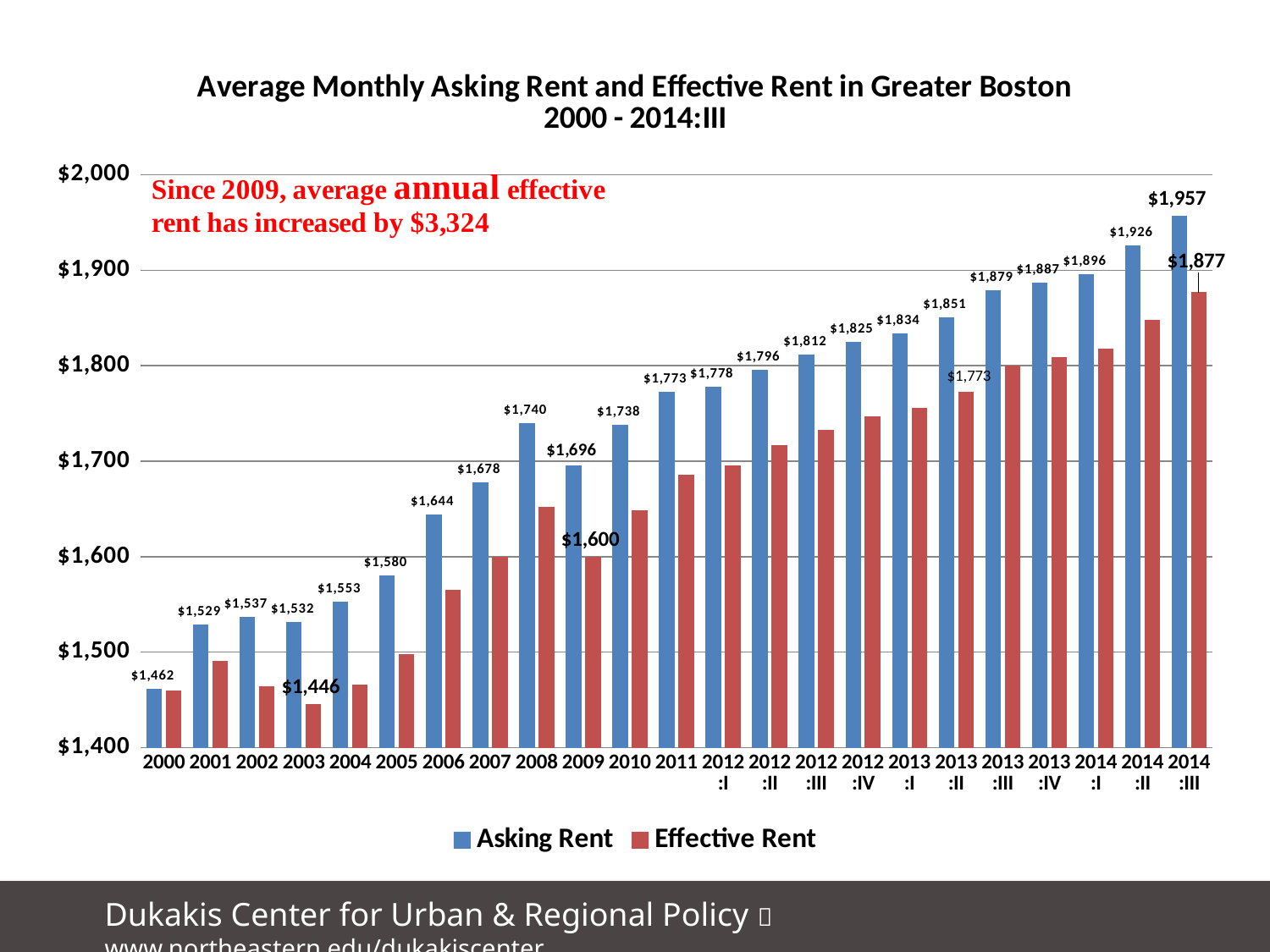
What is the difference between the Asking Rent and the Effective Rent in 2014:III? $80 What is the Asking Rent for 2014:III? $1,957 Which year had the higher Asking Rent, 2008 or 2009? 2008 What is the Effective Rent for 2014:III? $1,877 How many time periods are shown on the x axis? 23 Is the Effective Rent for 2014:II greater or less than $1,800? greater Which period has the highest Asking Rent? 2014:III By how much did the Asking Rent in 2014:III exceed the Asking Rent in 2000? $495 How many series does the legend list? 2 What is the Effective Rent for 2003? $1,446 Which period has the lowest Asking Rent? 2000 What kind of chart is shown on the slide? Bar chart